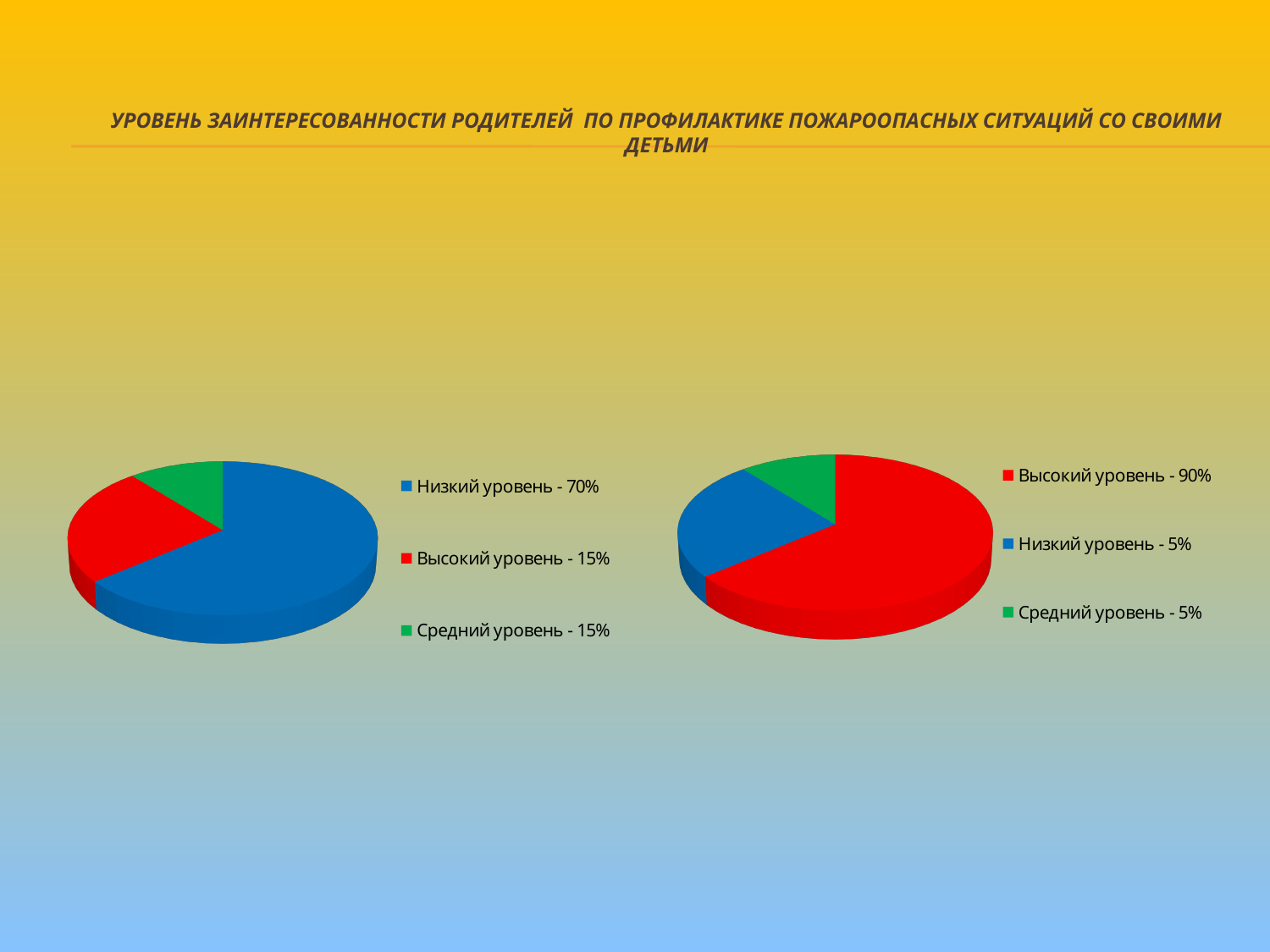
In the left pie chart, what is the difference between the shares of Низкий уровень and Высокий уровень? 55% In the right pie chart, what share does Средний уровень have? 5% In the left pie chart, what share does Низкий уровень have? 70% In the right pie chart, what share does Высокий уровень have? 90% In the left pie chart, which category has the largest slice? Низкий уровень In the right pie chart, which is larger: Высокий уровень or Низкий уровень? Высокий уровень In the left pie chart, what colour is the slice for Средний уровень? green In the right pie chart, what is the difference between the shares of Высокий уровень and Низкий уровень? 85% How many slices does the pie chart on the right side of the slide have? 3 What kind of chart is the chart on the left side of the slide? pie chart In the right pie chart, which category has the largest slice? Высокий уровень